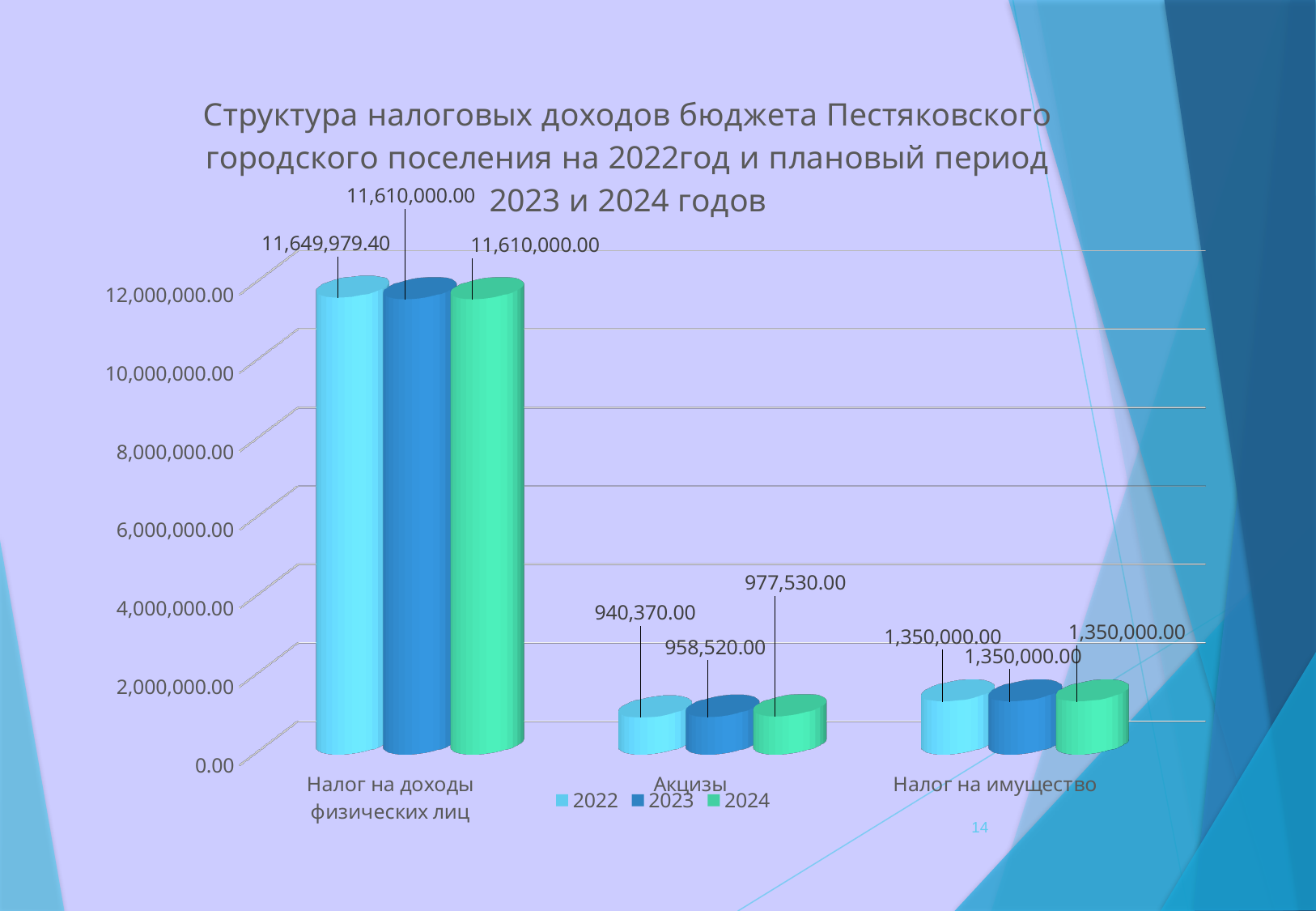
Which category has the highest values across all years? Налог на доходы физических лиц Which is larger: the 2022 value for "Акцизы" or the 2022 value for "Налог на имущество"? Налог на имущество What is the value for 2023 in the category "Акцизы"? 958,520.00 What is the value for 2024 in the category "Акцизы"? 977,530.00 Do the values for "Акцизы" rise or fall from 2022 to 2024? rise What is the value for 2022 in the category "Налог на доходы физических лиц"? 11,649,979.40 How many categories are shown on the x axis? 3 What is the difference between the 2024 and 2022 values for "Акцизы"? 37,160.00 What is the difference between the 2022 and 2023 values for "Налог на доходы физических лиц"? 39,979.40 Which category has the lowest values across all years? Акцизы How many series does the legend list? 3 What is the value for 2023 in the category "Налог на имущество"? 1,350,000.00